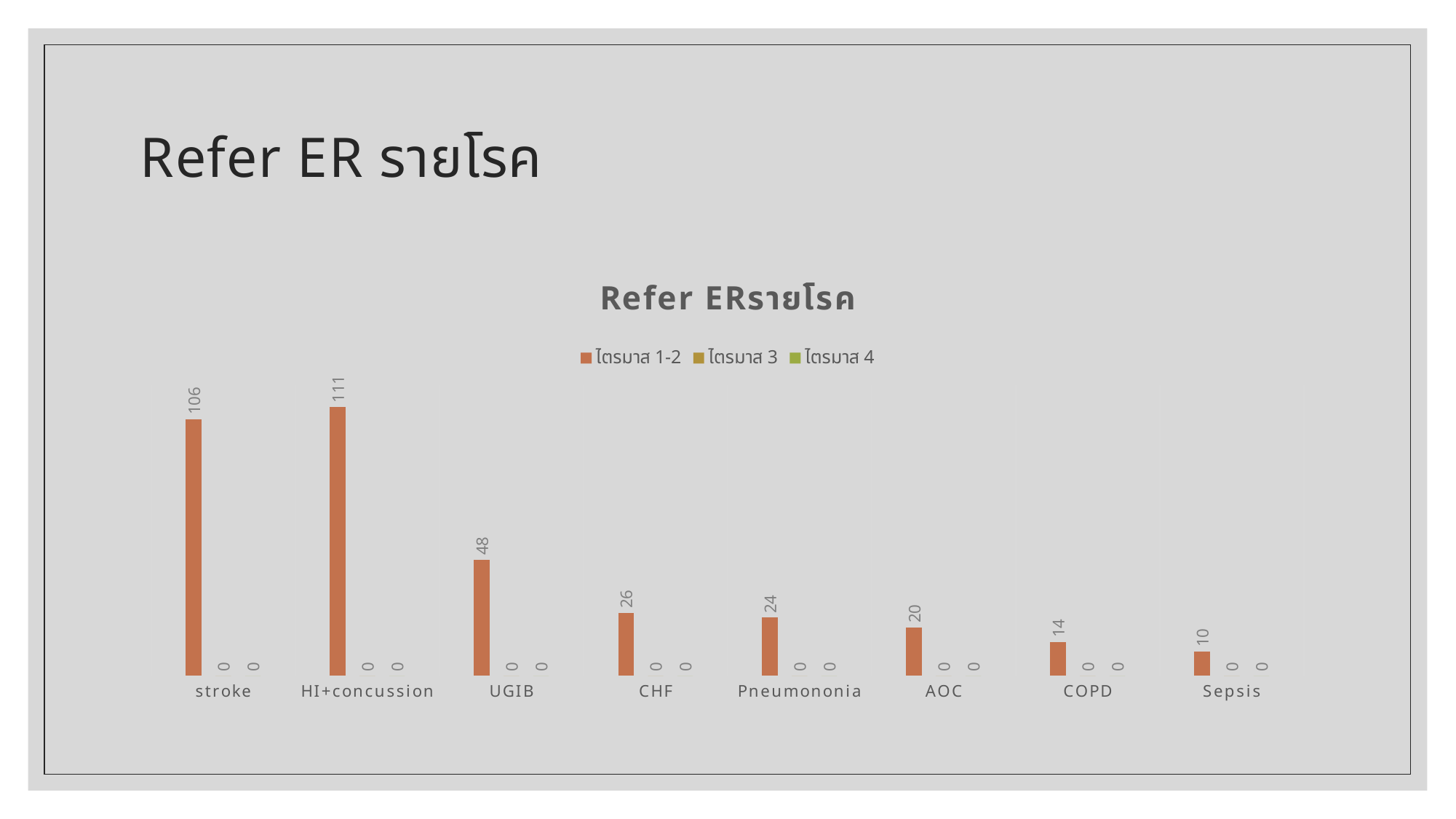
How many categories are shown on the x axis? 8 What is the value for COPD in the ไตรมาส 3 series? 0 What is the value for UGIB in the ไตรมาส 1-2 series? 48 Which category has the highest value in the ไตรมาส 1-2 series? HI+concussion What is the value for stroke in the ไตรมาส 1-2 series? 106 Which is larger in the ไตรมาส 1-2 series, CHF or Pneumononia? CHF What is the value for HI+concussion in the ไตรมาส 1-2 series? 111 What is the difference between the ไตรมาส 1-2 values for HI+concussion and stroke? 5 Which category has the lowest value in the ไตรมาส 1-2 series? Sepsis What kind of chart is shown on the slide? Bar chart What is the value for Sepsis in the ไตรมาส 1-2 series? 10 How many series does the legend list? 3